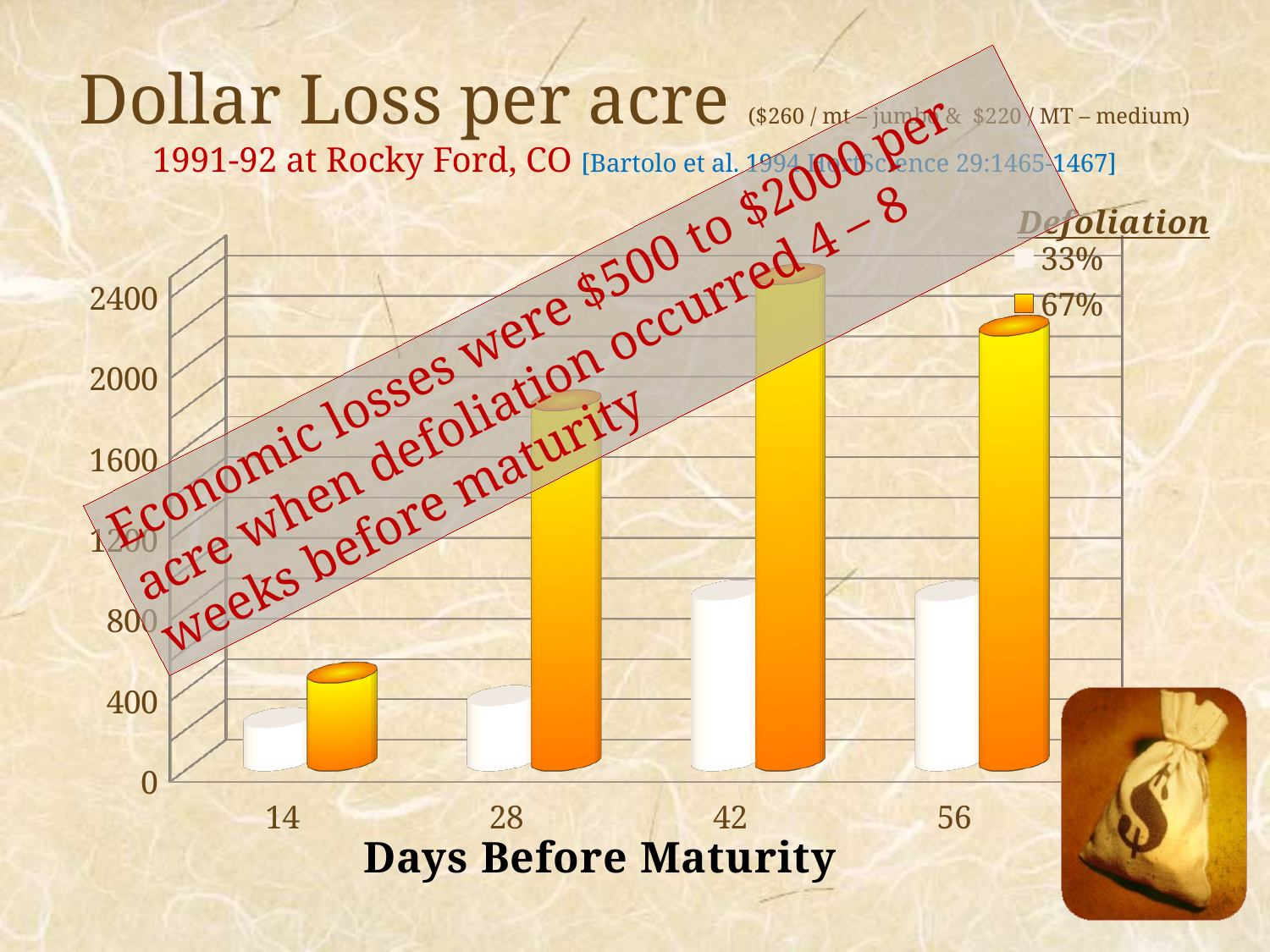
At which number of days before maturity is the 67% defoliation bar highest? 42 How many series does the legend list? 2 For 67% defoliation, is the dollar loss larger at 42 or at 56 days before maturity? 42 At 28 days before maturity, which defoliation level has the larger dollar loss, 33% or 67%? 67% How many categories are shown on the x axis? 4 What is the title of the x axis? Days Before Maturity What kind of chart is shown on the slide? bar chart At which number of days before maturity is the 33% defoliation bar lowest? 14 What are the two defoliation levels listed in the legend? 33% and 67% Is the value for 67% defoliation at 28 days before maturity greater or less than 1600? greater Is the value for 33% defoliation at 14 days before maturity greater or less than 400? less Does the 67% defoliation series rise or fall from 14 to 42 days before maturity? rise